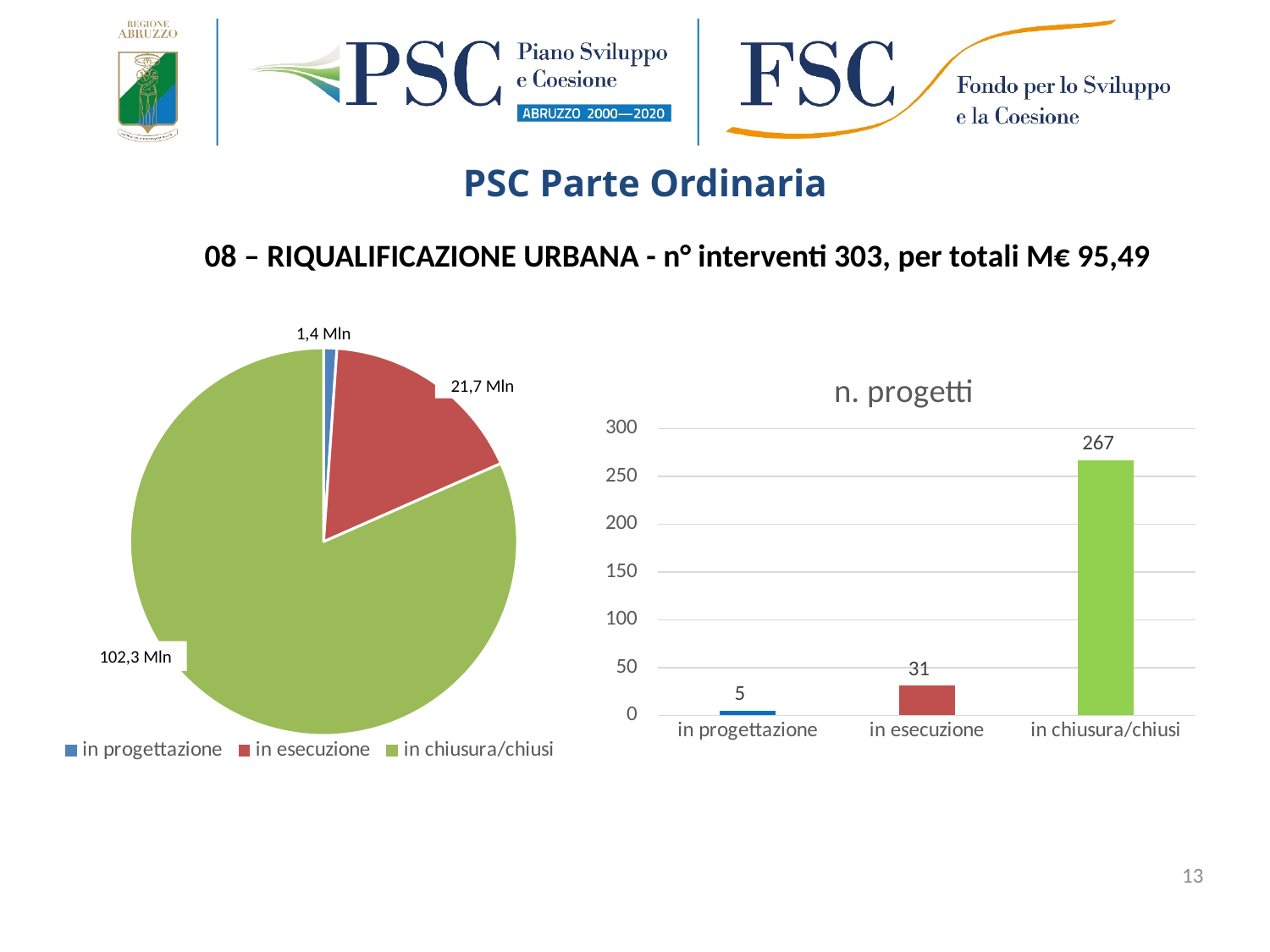
In the bar chart titled 'n. progetti', how many categories are shown on the x axis? 3 In the bar chart titled 'n. progetti', what is the value for 'in esecuzione'? 31 In the pie chart on the left, what colour is the slice for 'in esecuzione'? red What kind of chart is the chart on the right of the slide? bar chart In the bar chart titled 'n. progetti', what is the value for 'in chiusura/chiusi'? 267 In the pie chart on the left, which category has the smallest slice? in progettazione In the bar chart titled 'n. progetti', what is the value for 'in progettazione'? 5 In the pie chart on the left, which is larger: 'in esecuzione' or 'in progettazione'? in esecuzione In the bar chart titled 'n. progetti', what is the difference between 'in chiusura/chiusi' and 'in esecuzione'? 236 In the pie chart on the left, what is the value for 'in esecuzione'? 21,7 Mln In the pie chart on the left, what is the value for 'in chiusura/chiusi'? 102,3 Mln In the bar chart titled 'n. progetti', which category has the lowest value? in progettazione